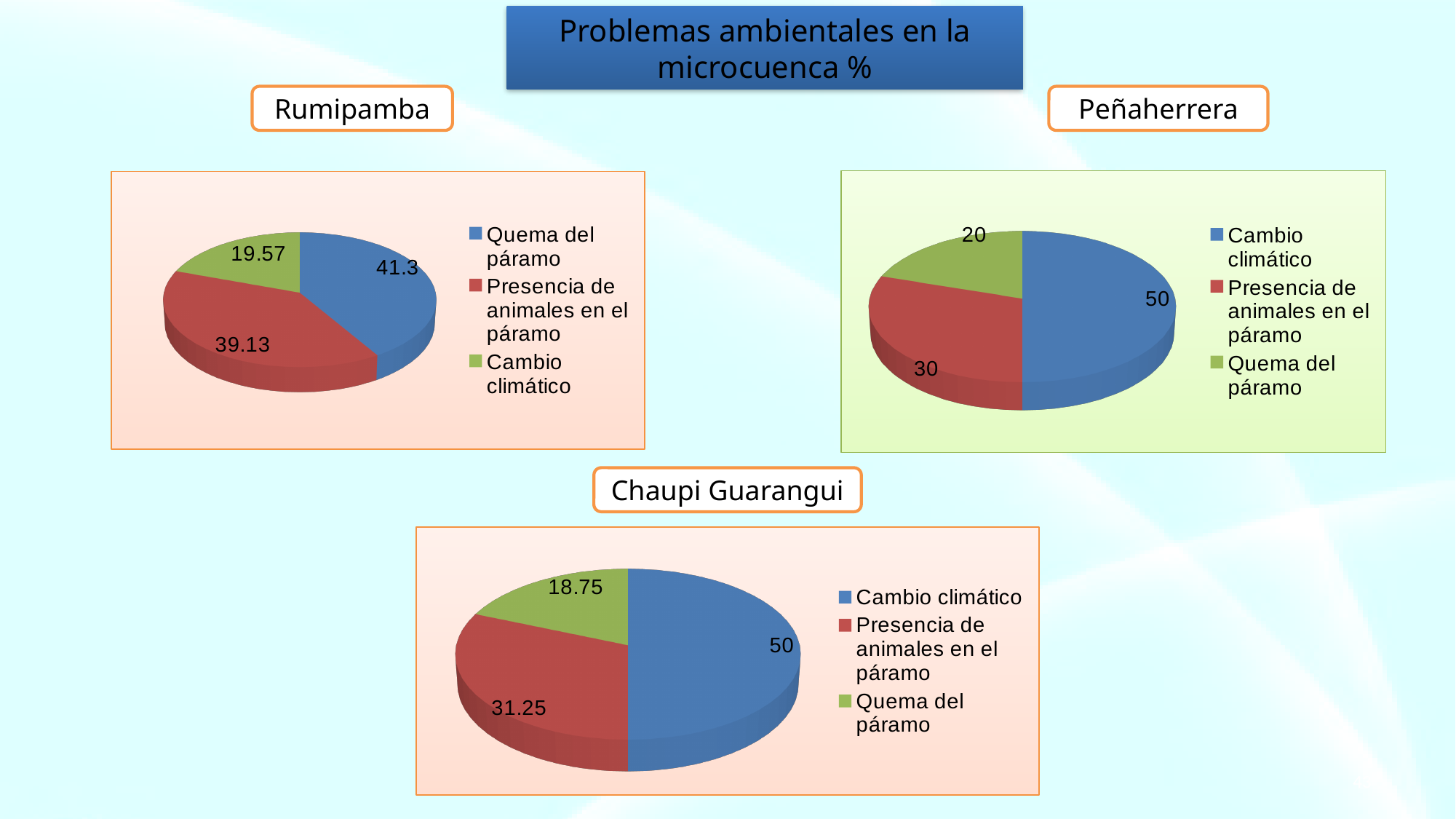
In the Rumipamba chart, which category has the smallest slice? Cambio climático In the Chaupi Guarangui chart, what is the difference between Presencia de animales en el páramo and Quema del páramo? 12.5 In the Rumipamba chart, what is the value for Quema del páramo? 41.3 In the Chaupi Guarangui chart, what is the value for Presencia de animales en el páramo? 31.25 In the Peñaherrera chart, what is the value for Cambio climático? 50 In the Chaupi Guarangui chart, which category has the largest slice? Cambio climático What type of chart is the Peñaherrera chart? Pie chart In the Rumipamba chart, what is the value for Presencia de animales en el páramo? 39.13 In the Rumipamba chart, which is larger: Quema del páramo or Cambio climático? Quema del páramo In the Peñaherrera chart, what is the value for Quema del páramo? 20 In the Peñaherrera chart, what is the difference between Cambio climático and Presencia de animales en el páramo? 20 How many categories does the Chaupi Guarangui chart's legend list? 3